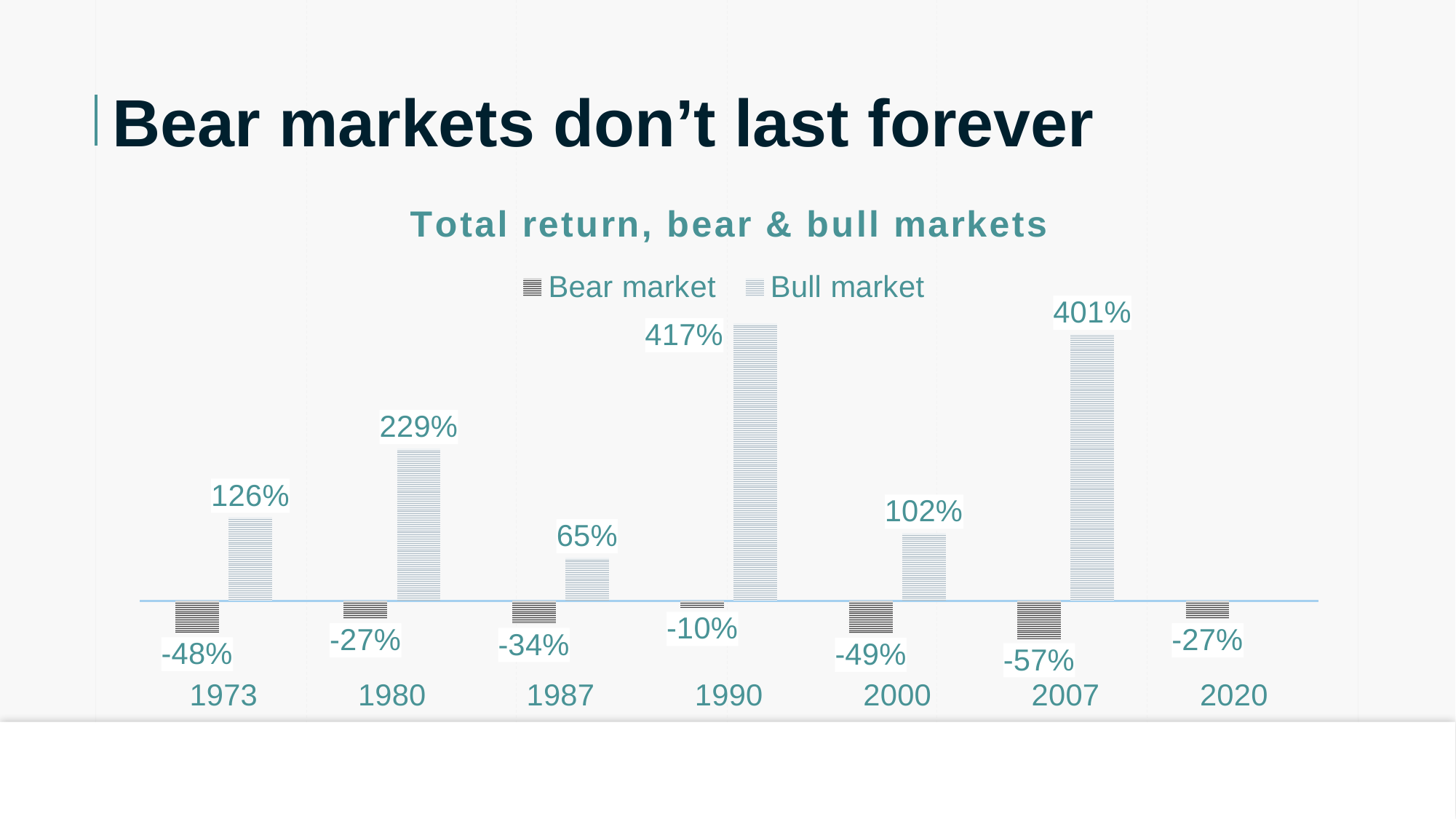
What is the title of the chart? Total return, bear & bull markets How many series does the legend list? 2 What is the bear market total return for 2007? -57% Which is larger, the bull market return for 1973 or for 2000? 1973 What is the bull market total return for 1980? 229% Which year has the lowest (most negative) bear market return? 2007 Which year has the highest bull market return? 1990 What is the bull market total return for 1990? 417% How many years are shown on the x axis? 7 What kind of chart is shown on the slide? Bar chart Which year has no bull market bar shown? 2020 What is the difference between the bull market returns for 1990 and 2007? 16%